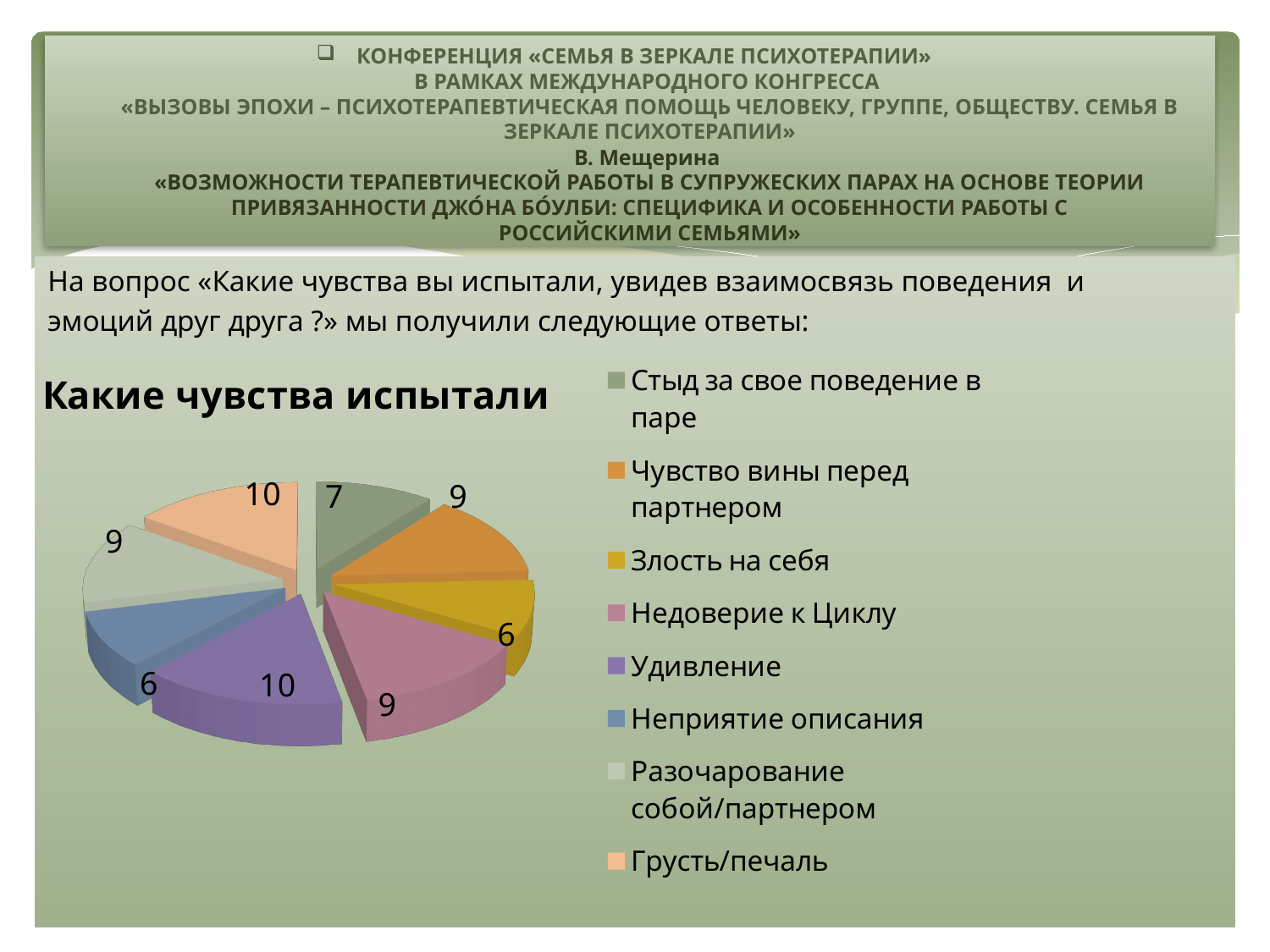
What is the difference between the values for «Удивление» and «Неприятие описания»? 4 What is the value for «Удивление»? 10 What is the value for «Чувство вины перед партнером»? 9 What is the value for «Злость на себя»? 6 What is the total of all the slice values in the chart? 66 What is the value for «Грусть/печаль»? 10 What kind of chart is shown on the slide? Pie chart How many categories does the legend of the chart list? 8 What is the title of the chart? Какие чувства испытали What is the difference between the values for «Недоверие к Циклу» and «Злость на себя»? 3 What is the value for «Стыд за свое поведение в паре»? 7 Which is larger: «Удивление» or «Стыд за свое поведение в паре»? Удивление